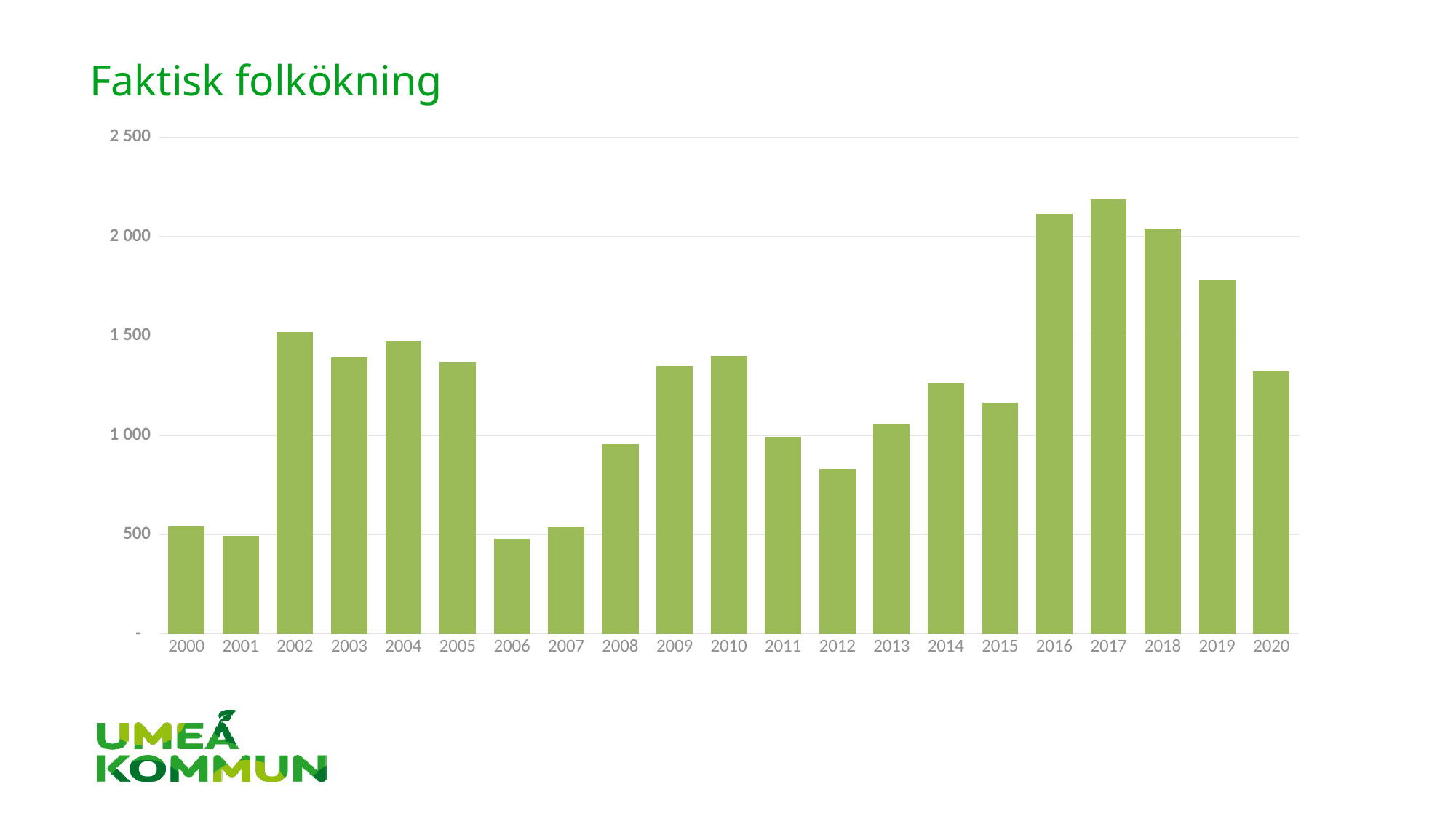
How many years are shown on the x axis of the chart? 21 Is the value for 2017 greater or less than 2 000? greater Is the value for 2019 greater or less than 1 500? greater Is the value for 2020 greater or less than 1 500? less Do the values rise or fall from 2017 to 2020? fall What kind of chart is shown on the slide? bar chart Which year has the larger value, 2016 or 2019? 2016 Which year has the highest bar in the chart? 2017 Which year has the larger value, 2014 or 2015? 2014 What is the title of the chart? Faktisk folkökning